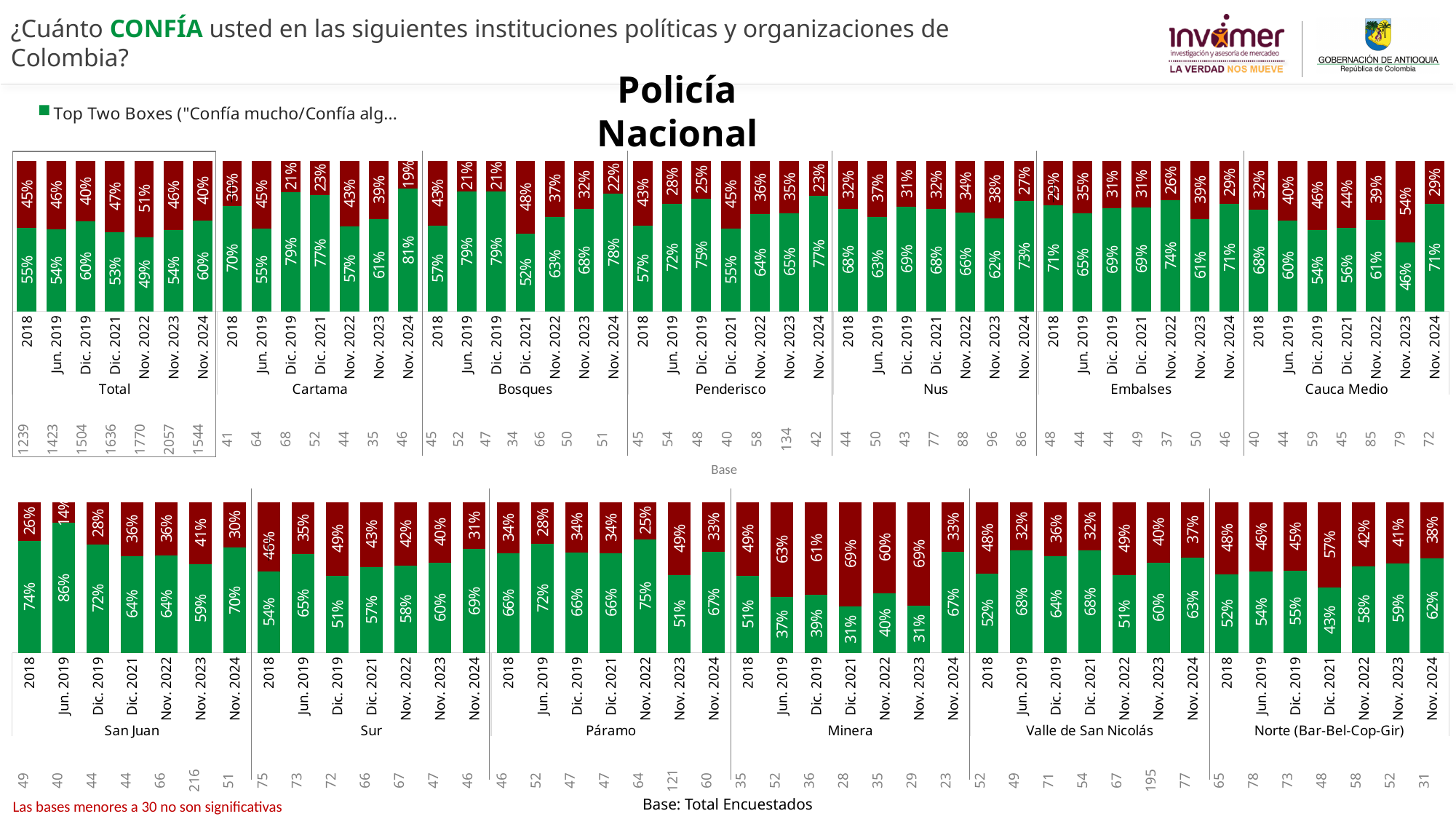
In the top chart, what is the difference between the green values for Cauca Medio in Nov. 2024 and Nov. 2023? 25% In the top chart, what is the green (Top Two Boxes) value for Total in Nov. 2024? 60% Which institution is the subject of the charts on this slide? Policía Nacional In the bottom chart, what is the base (number of respondents) for Valle de San Nicolás in Nov. 2023? 195 In the bottom chart, which year has the lowest green value within the San Juan group? Nov. 2023 In the bottom chart, which is larger: the green value for Sur in Nov. 2024 or for Páramo in Nov. 2024? Sur in Nov. 2024 In the bottom chart, what is the total of the green and red segments for Minera in Jun. 2019? 100% In the top chart, what is the green value for Cartama in Nov. 2024? 81% What type of chart is used on this slide? Stacked bar chart In the bottom chart, what is the red (upper segment) value for Minera in Dic. 2021? 69% In the top chart, how many time periods are shown for each region group? 7 In the top chart, which year has the highest green value within the Cartama group? Nov. 2024